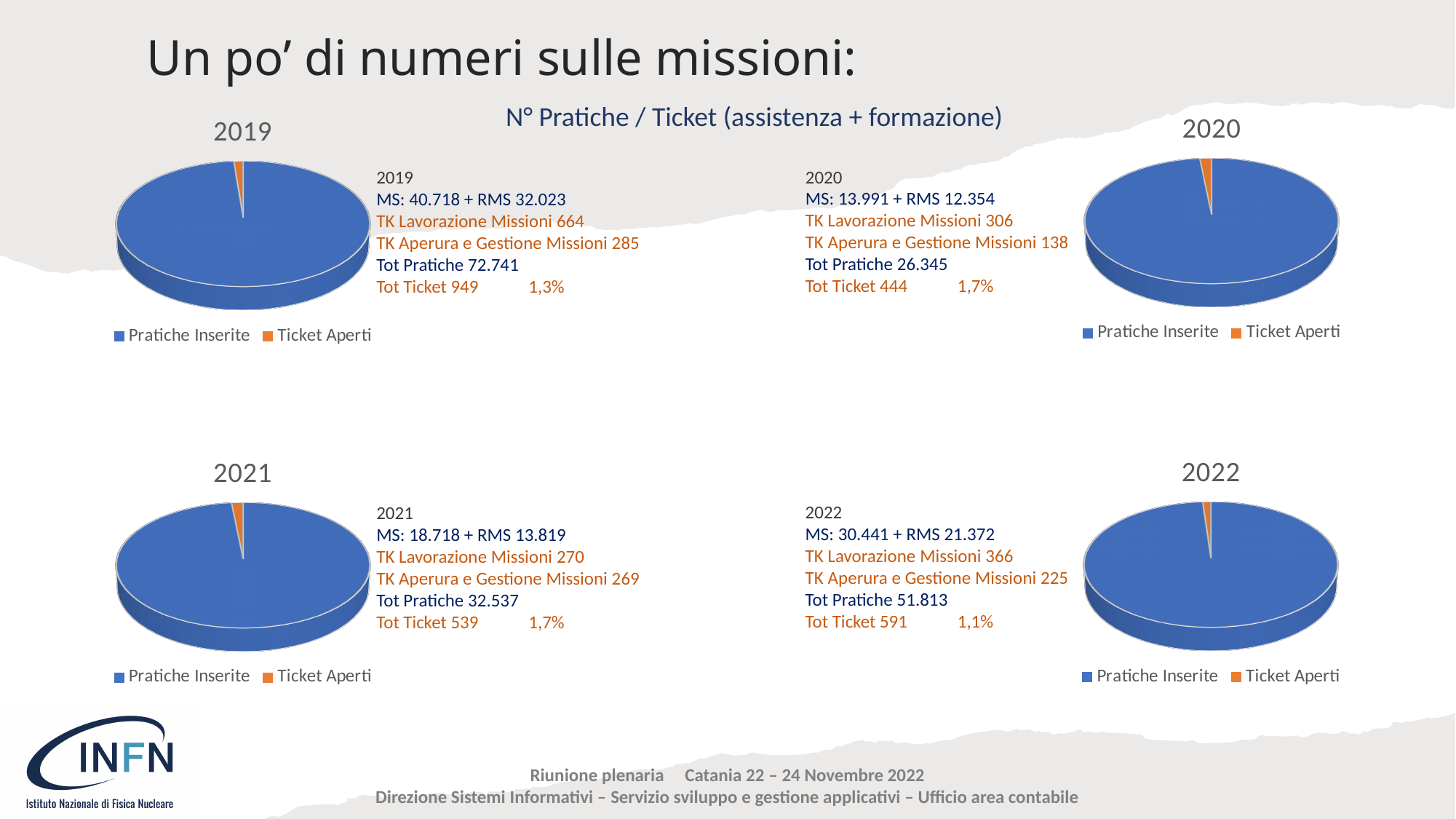
What is the Tot Ticket value printed for the 2020 chart? 444 How many series does the legend of the 2020 chart list? 2 What colour is the Ticket Aperti slice in the 2021 chart? orange In the 2022 chart, which category has the smallest slice? Ticket Aperti What are the two legend entries shown under the 2022 chart? Pratiche Inserite, Ticket Aperti How many slices does the 2021 pie chart have? 2 What kind of chart is the 2019 chart? pie chart In the 2019 chart, which slice is larger, Pratiche Inserite or Ticket Aperti? Pratiche Inserite In the 2020 chart, which category has the largest slice? Pratiche Inserite What share of the 2022 pie do the tickets (Tot Ticket) represent, as printed on the slide? 1,1% What share of the 2019 pie do the tickets (Tot Ticket) represent, as printed on the slide? 1,3% What is the Tot Pratiche value printed for the 2021 chart? 32.537